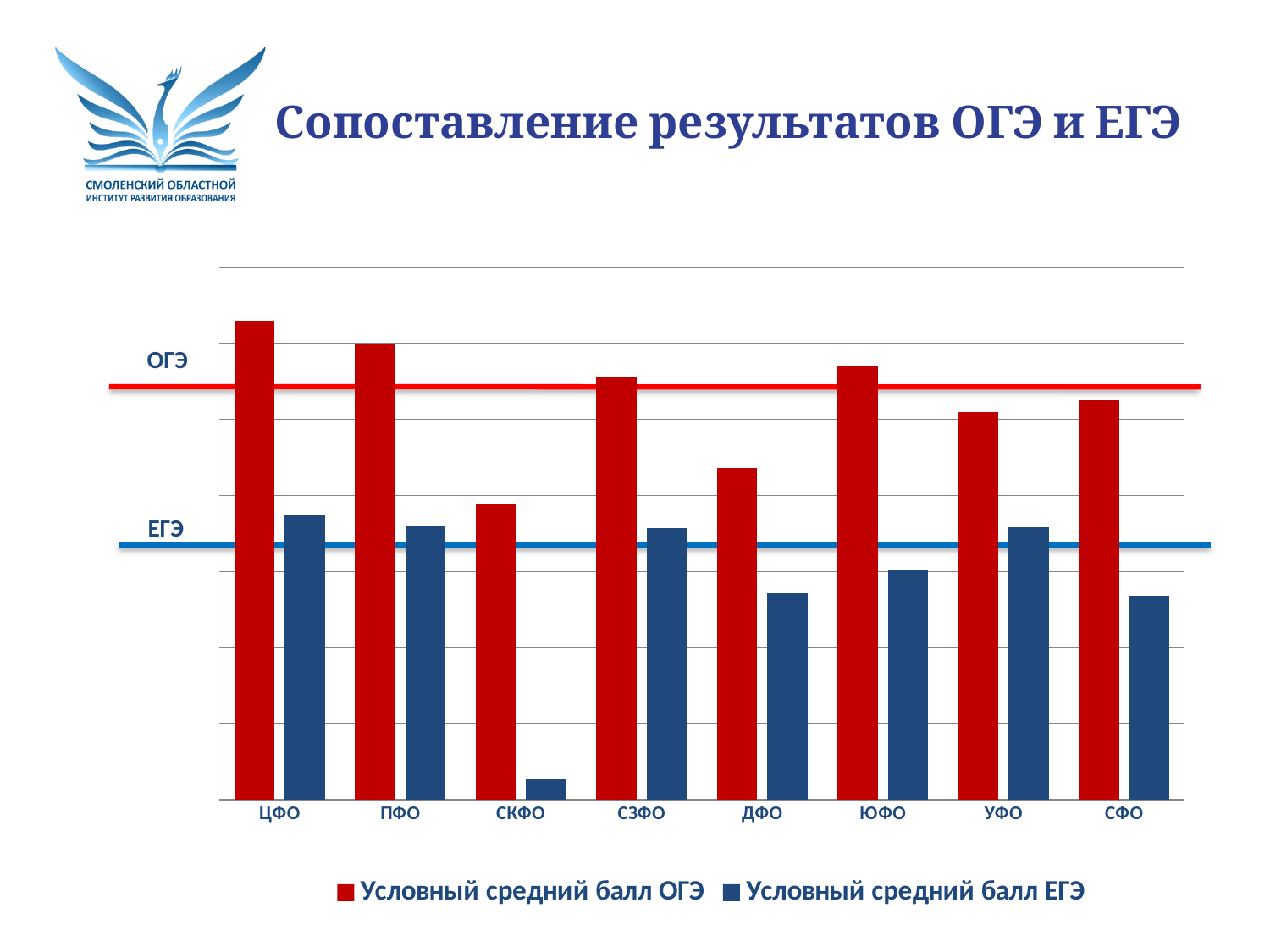
Which category has the lowest value for Условный средний балл ОГЭ? СКФО Which is larger for Условный средний балл ОГЭ: ДФО or УФО? УФО Which is larger for Условный средний балл ЕГЭ: ЮФО or ДФО? ЮФО Which category has the lowest value for Условный средний балл ЕГЭ? СКФО How many categories (federal districts) are shown on the x axis? 8 What colour are the bars for Условный средний балл ЕГЭ? blue What kind of chart is shown on the slide? bar chart What is the title of the slide containing the chart? Сопоставление результатов ОГЭ и ЕГЭ How many series does the legend list? 2 Which category has the highest value for Условный средний балл ОГЭ? ЦФО For ЦФО, which series has the larger value: Условный средний балл ОГЭ or Условный средний балл ЕГЭ? Условный средний балл ОГЭ